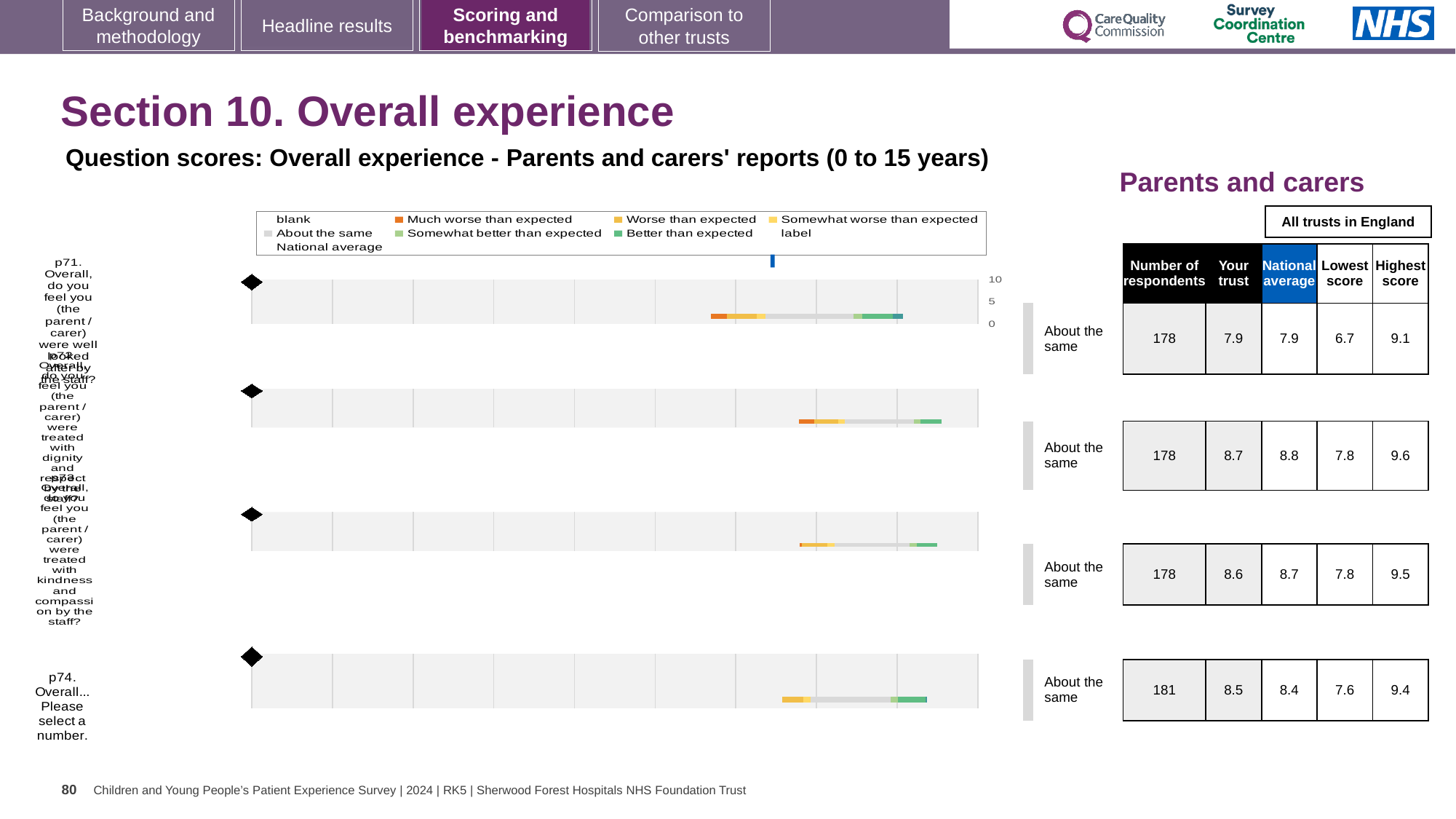
Is the 'Your trust' score for p74 greater or less than 5? greater What colour represents 'Much worse than expected' in the legend? orange How many question rows (bars) are plotted in the Overall experience chart? 4 Which row has the lowest 'Your trust' score? p71 (7.9) What is the highest score across all trusts in England for p71? 9.1 What kind of chart is used to show the question scores for Overall experience? bar chart What is the 'Your trust' score for p74 (Overall... Please select a number)? 8.5 What is the difference between the 'Your trust' score and the national average for p74? 0.1 For the second row, which is larger: the 'Your trust' score or the national average? National average (8.8) What benchmark category is shown next to each of the four question rows? About the same Which row has the highest 'Your trust' score? the second row (8.7) What is the number of respondents for p74? 181